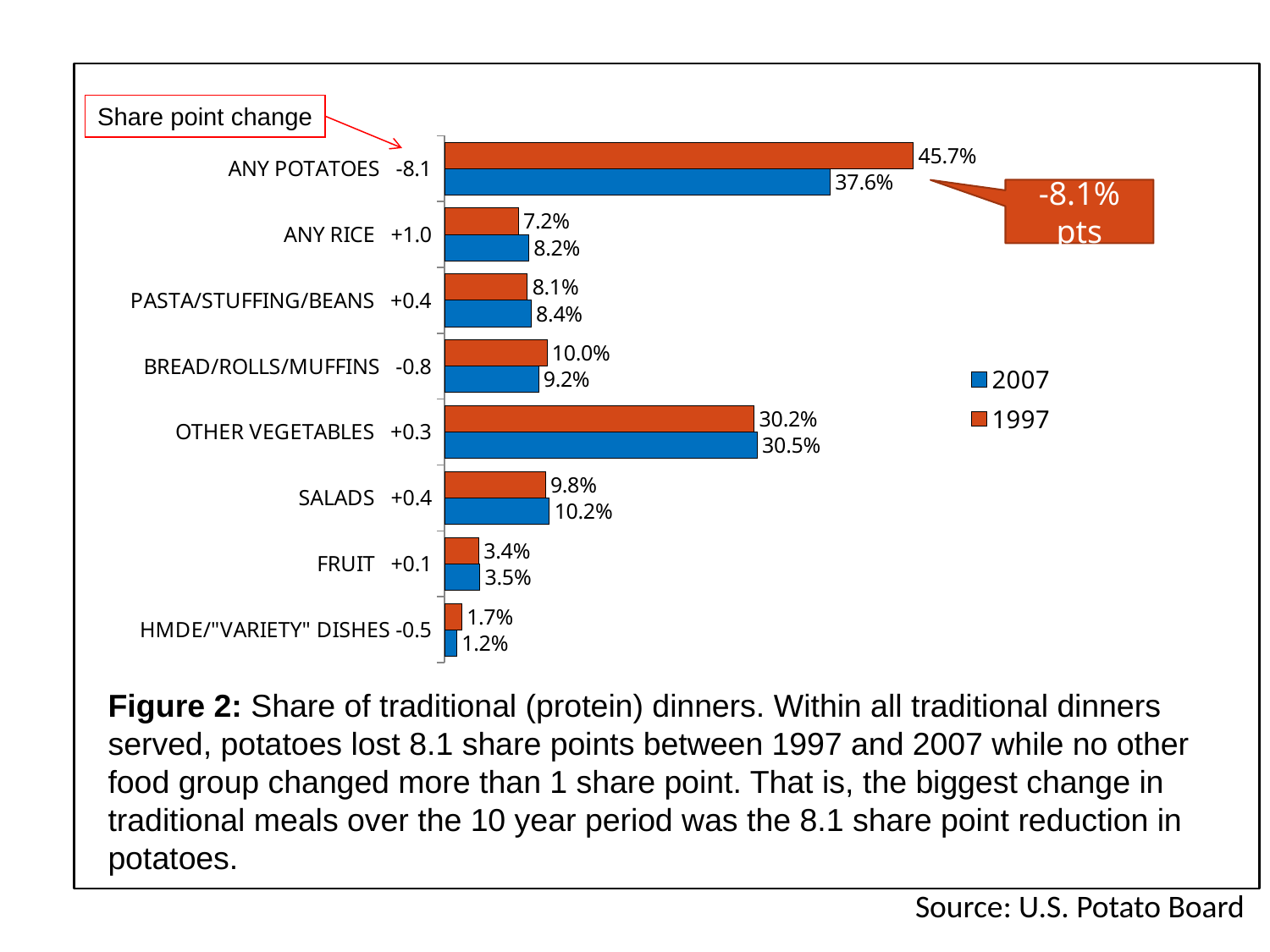
Which category had the highest share in 2007? ANY POTATOES What was the share for ANY POTATOES in 1997? 45.7% Which colour represents the 1997 series in the chart? Orange What kind of chart is shown on the slide? Bar chart What is the difference between the 1997 and 2007 shares for ANY POTATOES? 8.1 percentage points What was the share for SALADS in 2007? 10.2% Which category had the lowest share in 1997? HMDE/"VARIETY" DISHES How many food categories are shown in the chart? 8 What was the share for ANY POTATOES in 2007? 37.6% How many series does the legend list? 2 Which is larger, the 2007 share for ANY RICE or the 2007 share for FRUIT? ANY RICE What was the share for BREAD/ROLLS/MUFFINS in 1997? 10.0%